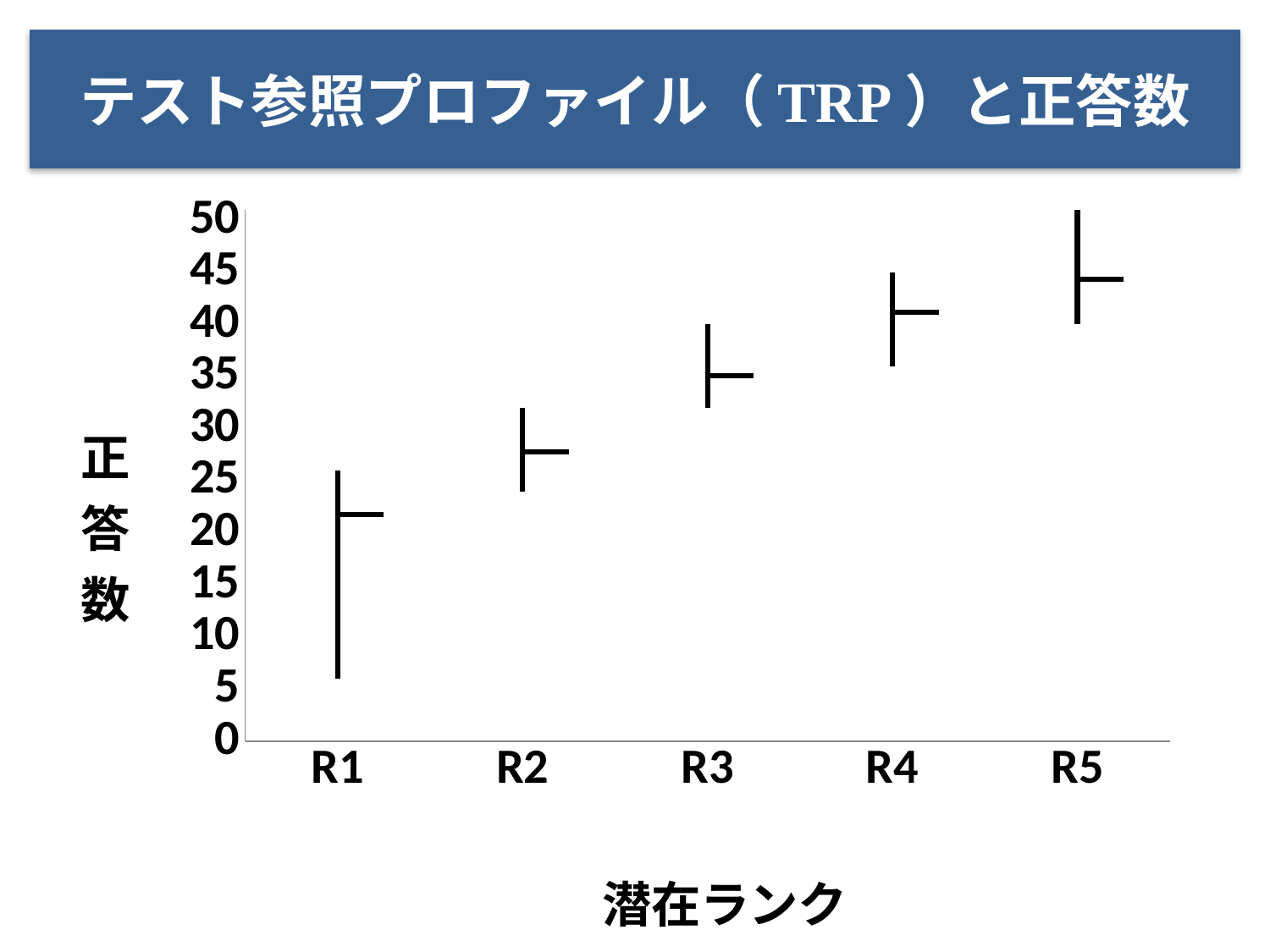
Do the 正答数 markers rise or fall from R1 to R5? rise Is the marker value for R3 greater or less than 30? greater Which latent rank has the lowest marker for 正答数? R1 How many latent rank categories are shown on the x axis? 5 Is the marker value for R1 greater or less than 25? less Which latent rank has the highest marker for 正答数? R5 Is the marker value for R2 greater or less than 25? greater What is the label of the x axis? 潜在ランク Which has the larger marker value, R2 or R4? R4 What is the title of the slide? テスト参照プロファイル（TRP）と正答数